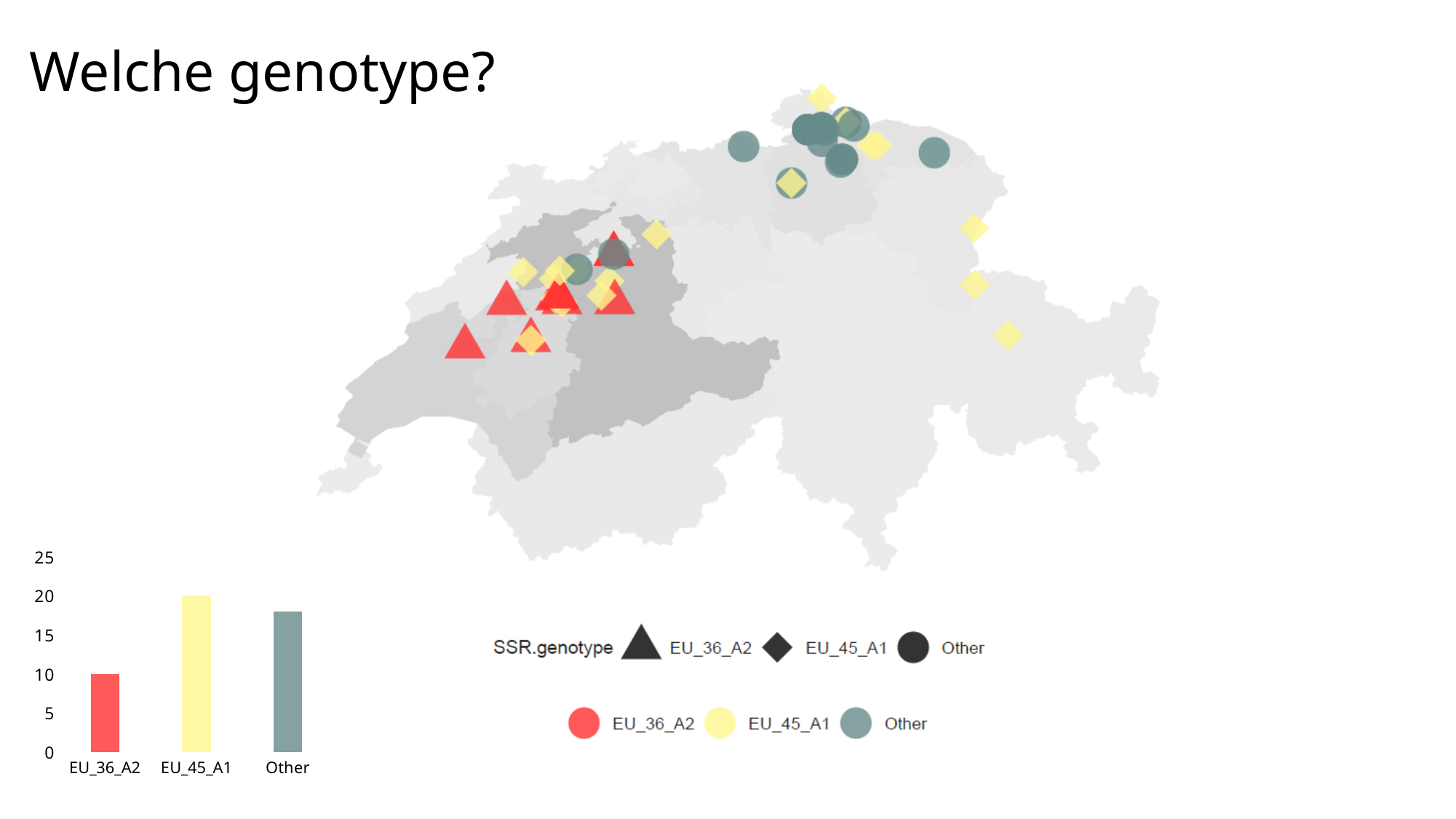
In the bar chart at the bottom left, which category has the lowest bar? EU_36_A2 How many categories are shown in the bar chart at the bottom left? 3 What is the highest tick value on the vertical axis of the bar chart at the bottom left? 25 In the bar chart at the bottom left, is the value for Other greater or less than 15? greater In the bar chart at the bottom left, which is larger, the value for Other or the value for EU_36_A2? Other In the bar chart at the bottom left, what is the value for EU_36_A2? 10 What colour is the EU_45_A1 bar in the bar chart at the bottom left? yellow In the bar chart at the bottom left, what is the value for EU_45_A1? 20 In the bar chart at the bottom left, which category has the highest bar? EU_45_A1 In the bar chart at the bottom left, is the value for Other greater or less than 20? less In the bar chart at the bottom left, what is the difference between the values for EU_45_A1 and EU_36_A2? 10 What kind of chart is shown at the bottom left of the slide? bar chart